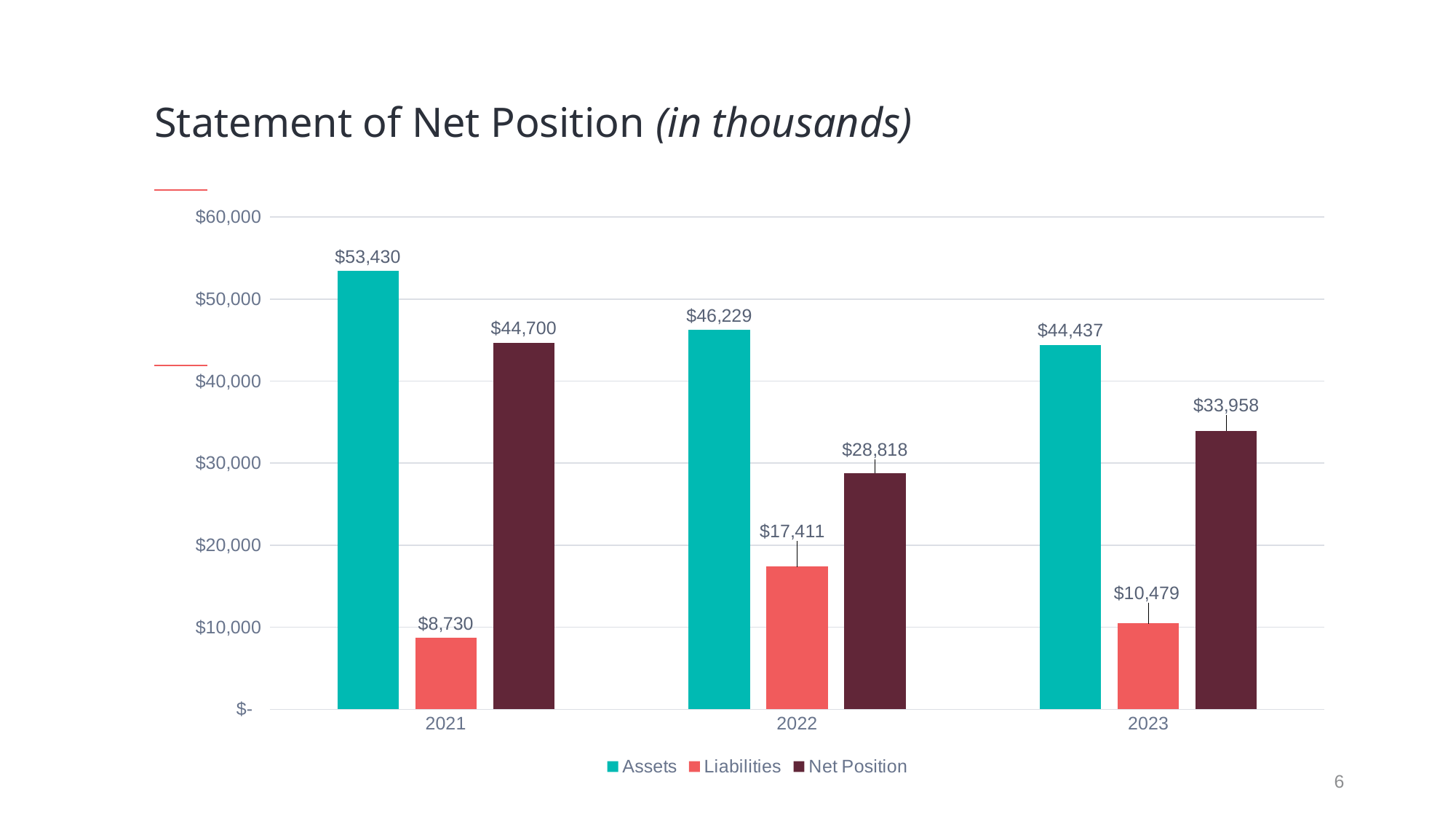
Which is larger: Net Position in 2021 or Assets in 2023? Net Position in 2021 What is the value of Assets in 2021? $53,430 What colour represents Liabilities in the chart? Red Do the Assets values rise or fall from 2021 to 2023? Fall What is the Net Position value for 2023? $33,958 What is the value of Liabilities in 2022? $17,411 In which year are Liabilities highest? 2022 In which year is the Net Position lowest? 2022 How many series does the legend list? 3 How many years are shown on the x axis? 3 What is the difference between Assets and Liabilities in 2023? $33,958 What kind of chart is shown on the slide? Bar chart